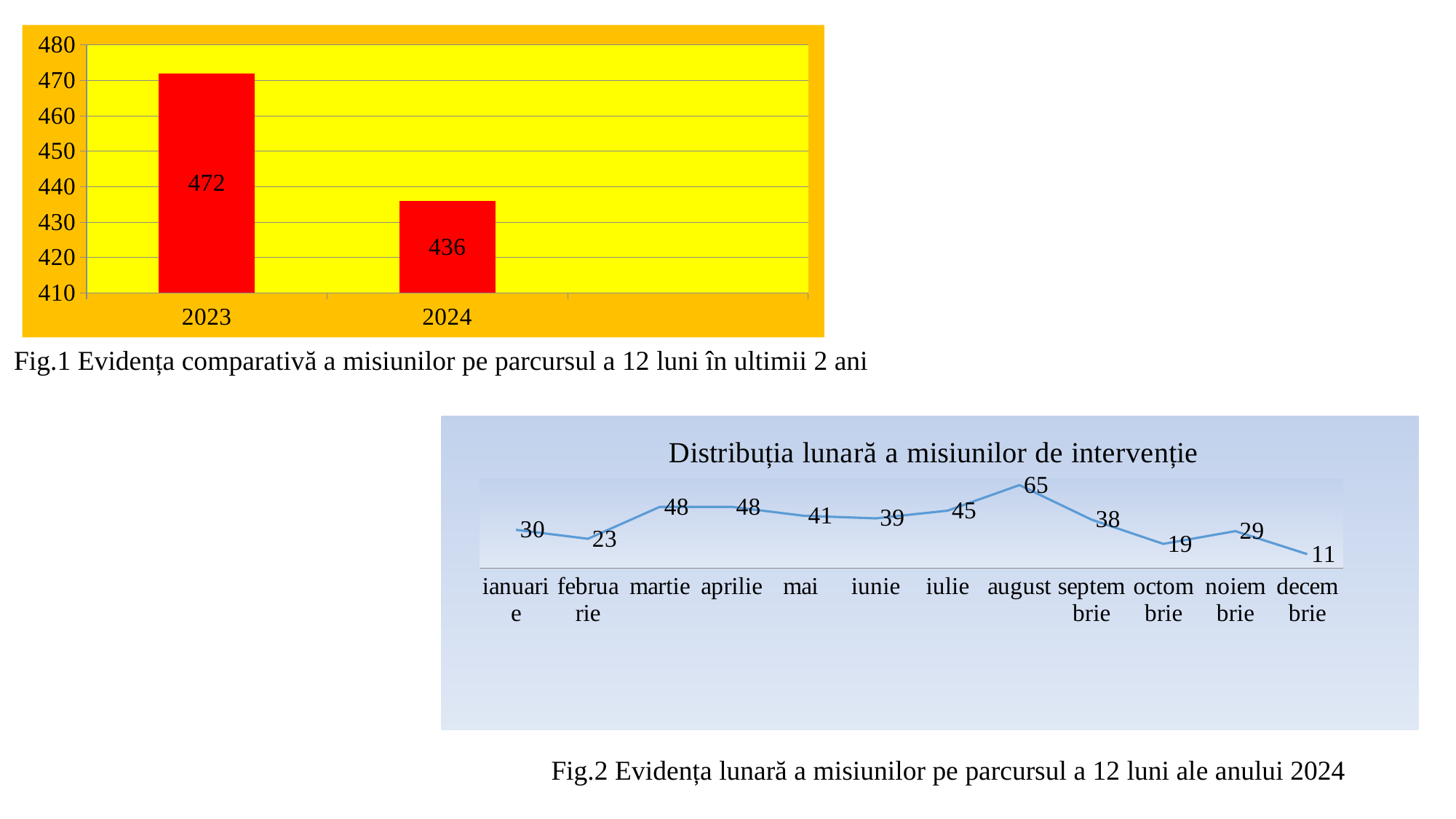
In the Fig.1 bar chart at the top left, which year has the larger value, 2023 or 2024? 2023 In the chart titled 'Distribuția lunară a misiunilor de intervenție', which month has the lowest value? decembrie In the chart titled 'Distribuția lunară a misiunilor de intervenție', what is the value for februarie? 23 What kind of chart is Fig.1 at the top left of the slide? Bar chart In the Fig.1 bar chart at the top left, what is the value for 2023? 472 In the chart titled 'Distribuția lunară a misiunilor de intervenție', which month has the highest value? august What kind of chart is Fig.2, titled 'Distribuția lunară a misiunilor de intervenție'? Line chart In the chart titled 'Distribuția lunară a misiunilor de intervenție', what is the difference between the values for august and septembrie? 27 In the chart titled 'Distribuția lunară a misiunilor de intervenție', what is the value for august? 65 In the Fig.1 bar chart at the top left, what is the difference between the 2023 and 2024 values? 36 In the chart titled 'Distribuția lunară a misiunilor de intervenție', how many months are plotted? 12 In the Fig.1 bar chart at the top left, what is the value for 2024? 436